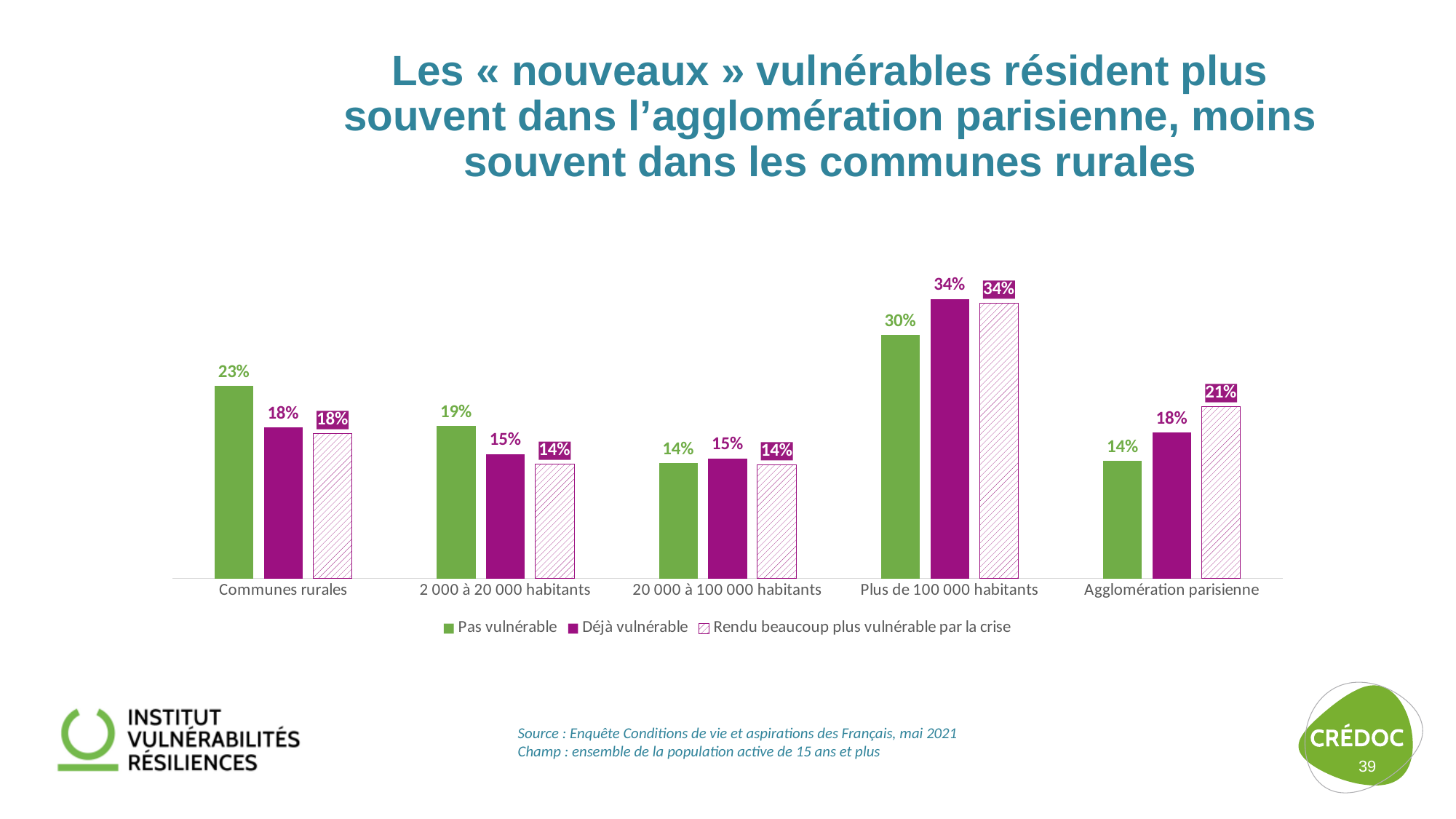
How many series does the legend list? 3 Which category has the highest value for "Pas vulnérable"? Plus de 100 000 habitants What is the value for "Pas vulnérable" in Communes rurales? 23% In Agglomération parisienne, which is larger: "Pas vulnérable" or "Rendu beaucoup plus vulnérable par la crise"? Rendu beaucoup plus vulnérable par la crise What is the value for "Rendu beaucoup plus vulnérable par la crise" in Agglomération parisienne? 21% Which series is shown with a hatched pattern? Rendu beaucoup plus vulnérable par la crise What kind of chart is shown on the slide? Bar chart What is the value for "Déjà vulnérable" in Plus de 100 000 habitants? 34% How many categories are shown on the x axis? 5 What is the difference between "Pas vulnérable" and "Rendu beaucoup plus vulnérable par la crise" in Communes rurales? 5 percentage points Which category has the lowest value for "Rendu beaucoup plus vulnérable par la crise"? 2 000 à 20 000 habitants and 20 000 à 100 000 habitants (both 14%) What is the value for "Pas vulnérable" in 20 000 à 100 000 habitants? 14%